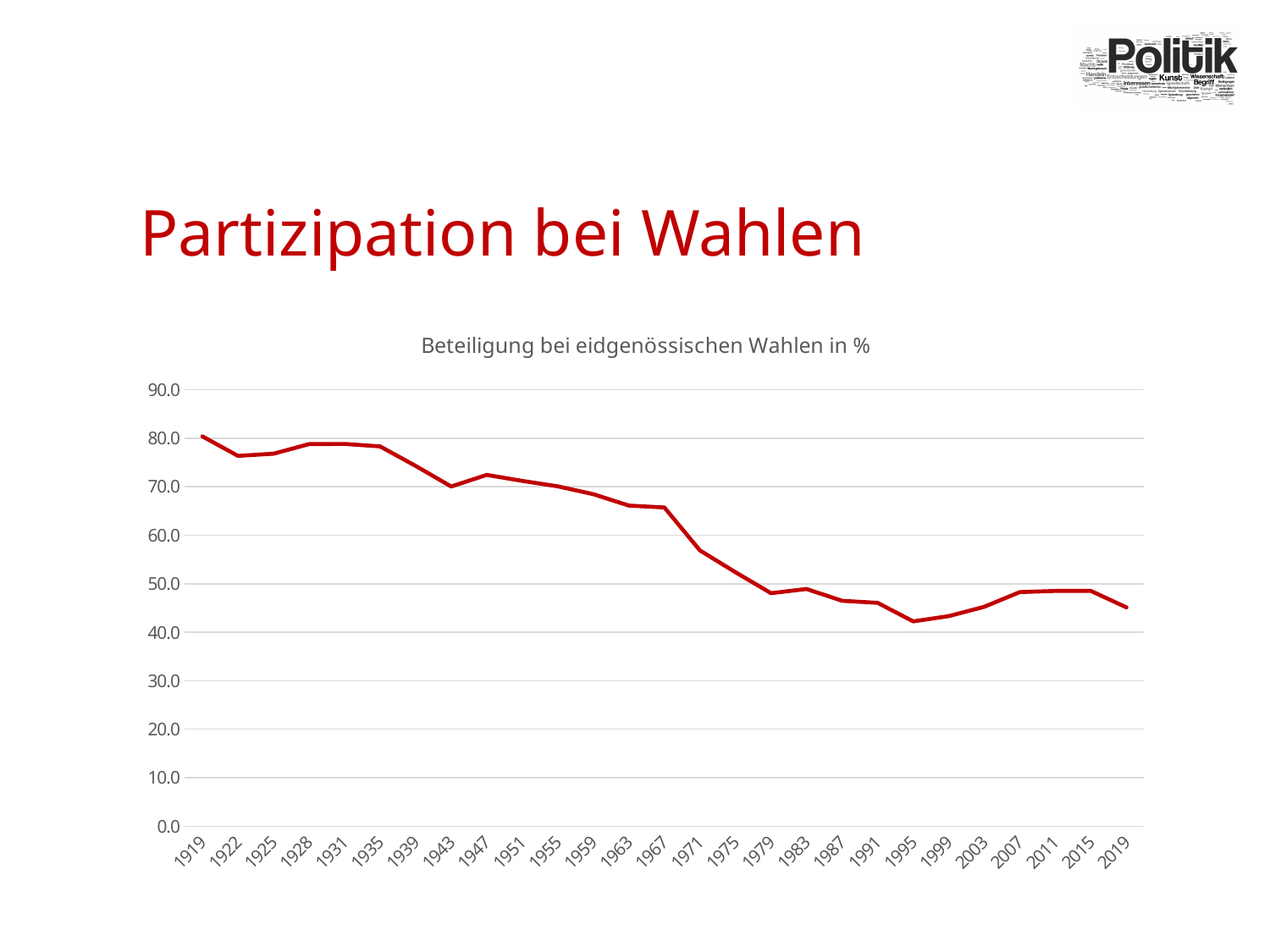
How many election years are plotted on the x axis? 27 What kind of chart is shown on the slide? line chart Overall, do the values rise or fall from 1919 to 2019? fall Is the value for 1919 greater or less than 70? greater Which year has the highest participation value? 1919 Is the value for 1995 greater or less than 50? less Which year has the larger value, 1943 or 1947? 1947 What is the title of the chart? Beteiligung bei eidgenössischen Wahlen in % Is the value for 1971 greater or less than 50? greater Which year has the lowest participation value? 1995 Which year has the larger value, 1919 or 2019? 1919